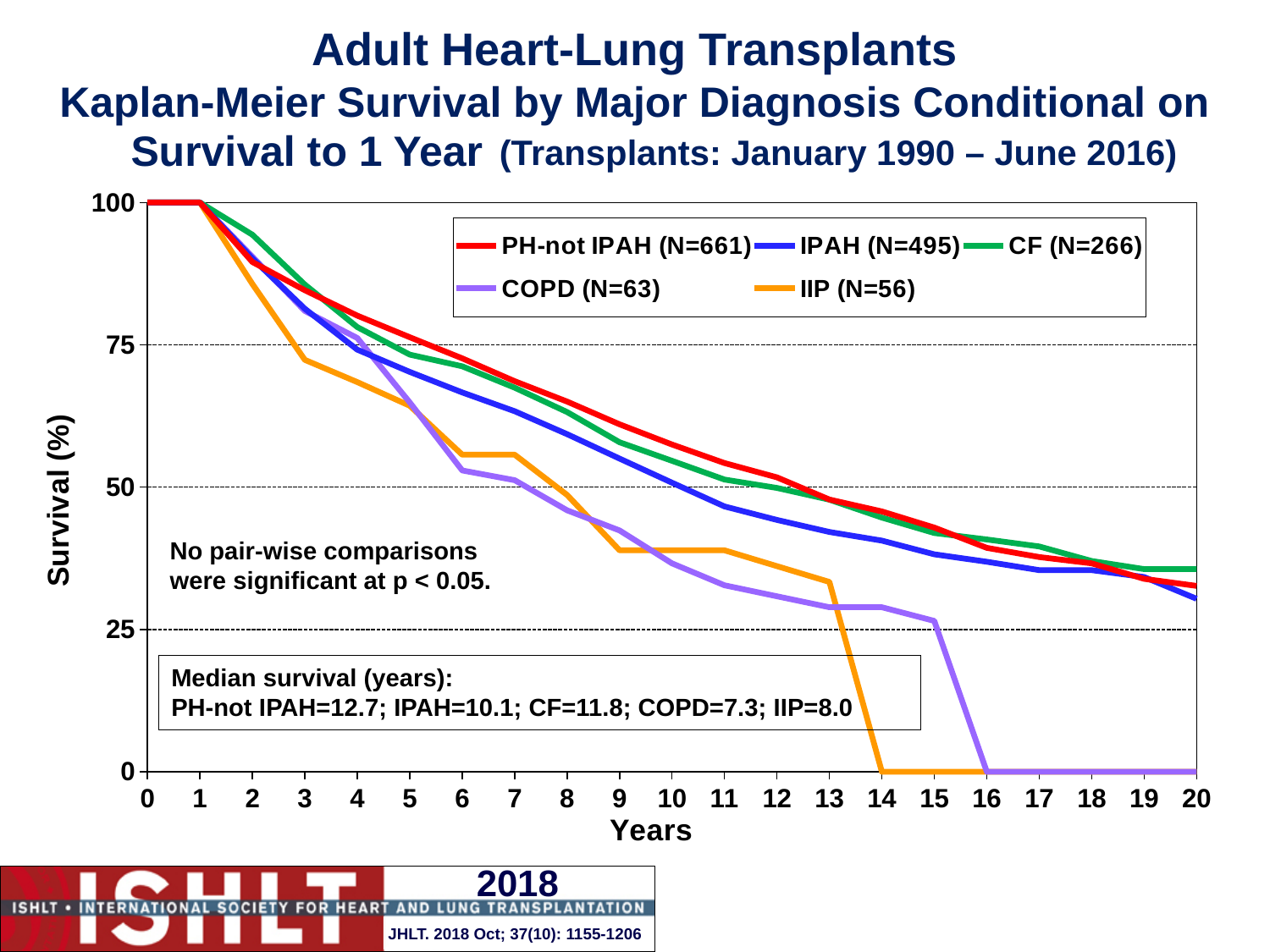
Which diagnosis group has the shortest median survival according to the text box? COPD Which diagnosis group has the longest median survival according to the text box? PH-not IPAH What is the median survival in years for CF, as printed in the text box? 11.8 What is the difference in median survival (years) between PH-not IPAH and COPD? 5.4 Is the survival value for the IPAH curve at 15 years greater or less than 50? less Is the survival value for the PH-not IPAH curve at 10 years greater or less than 50? greater At 10 years, which curve is higher: PH-not IPAH or COPD? PH-not IPAH Do the survival curves rise or fall as years increase? fall What is the median survival in years for COPD, as printed in the text box? 7.3 What is the number of patients (N) in the PH-not IPAH group shown in the legend? 661 What kind of chart is shown on the slide? line chart How many series does the legend list? 5